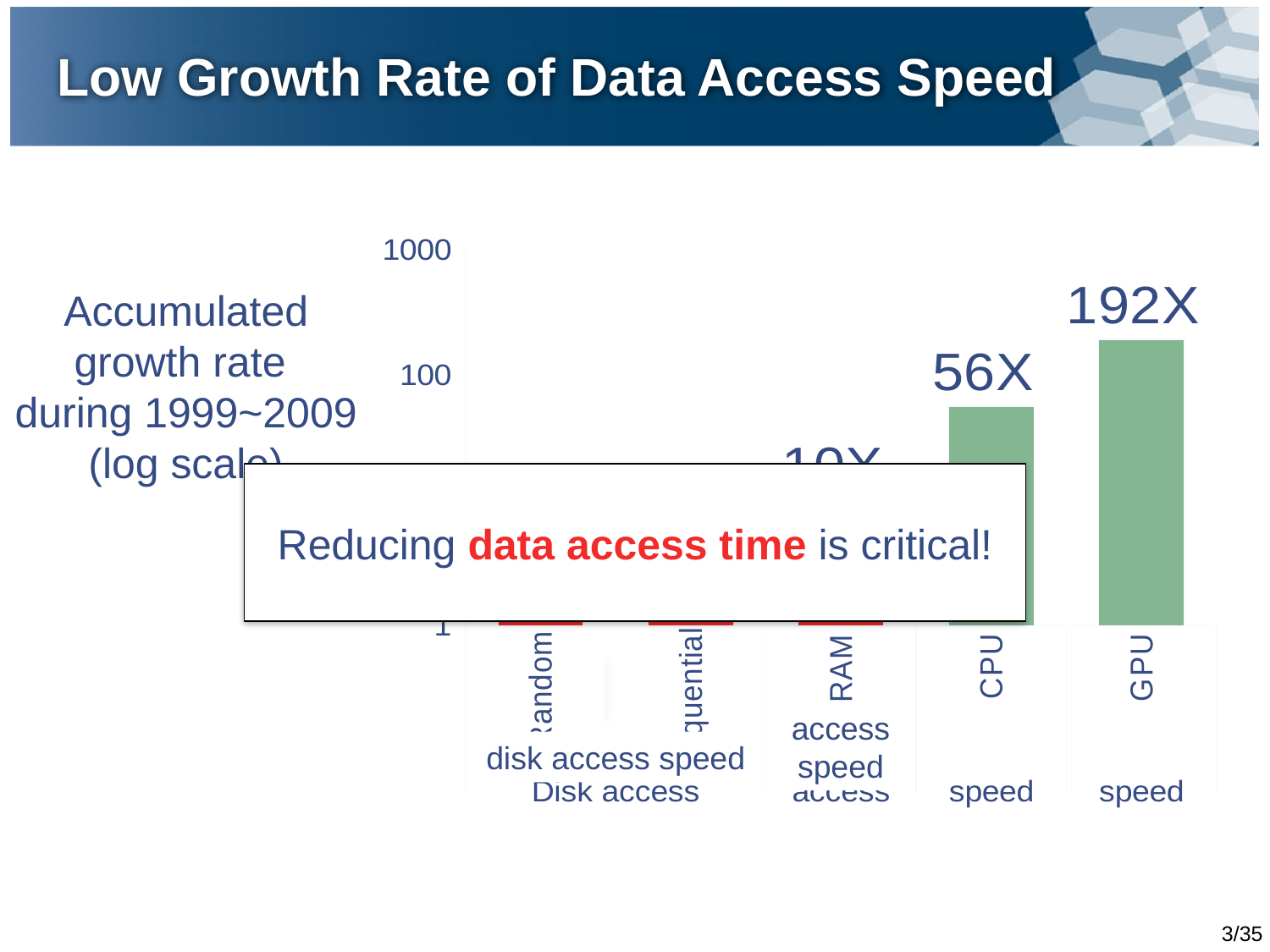
Which has a larger growth rate, CPU speed or GPU speed? GPU speed What colour are the CPU speed and GPU speed bars? green What is the highest tick value shown on the vertical axis? 1000 Do the bar values rise or fall from left to right across the chart? rise What kind of chart is shown on the slide? bar chart What is the accumulated growth rate shown for GPU speed? 192X Which category has the highest accumulated growth rate? GPU speed How many categories are plotted on the chart? 5 Is the value for CPU speed greater or less than 100? less Is the value for GPU speed greater or less than 100? greater What is the accumulated growth rate shown for CPU speed? 56X What is the difference between the GPU speed growth rate and the CPU speed growth rate? 136X